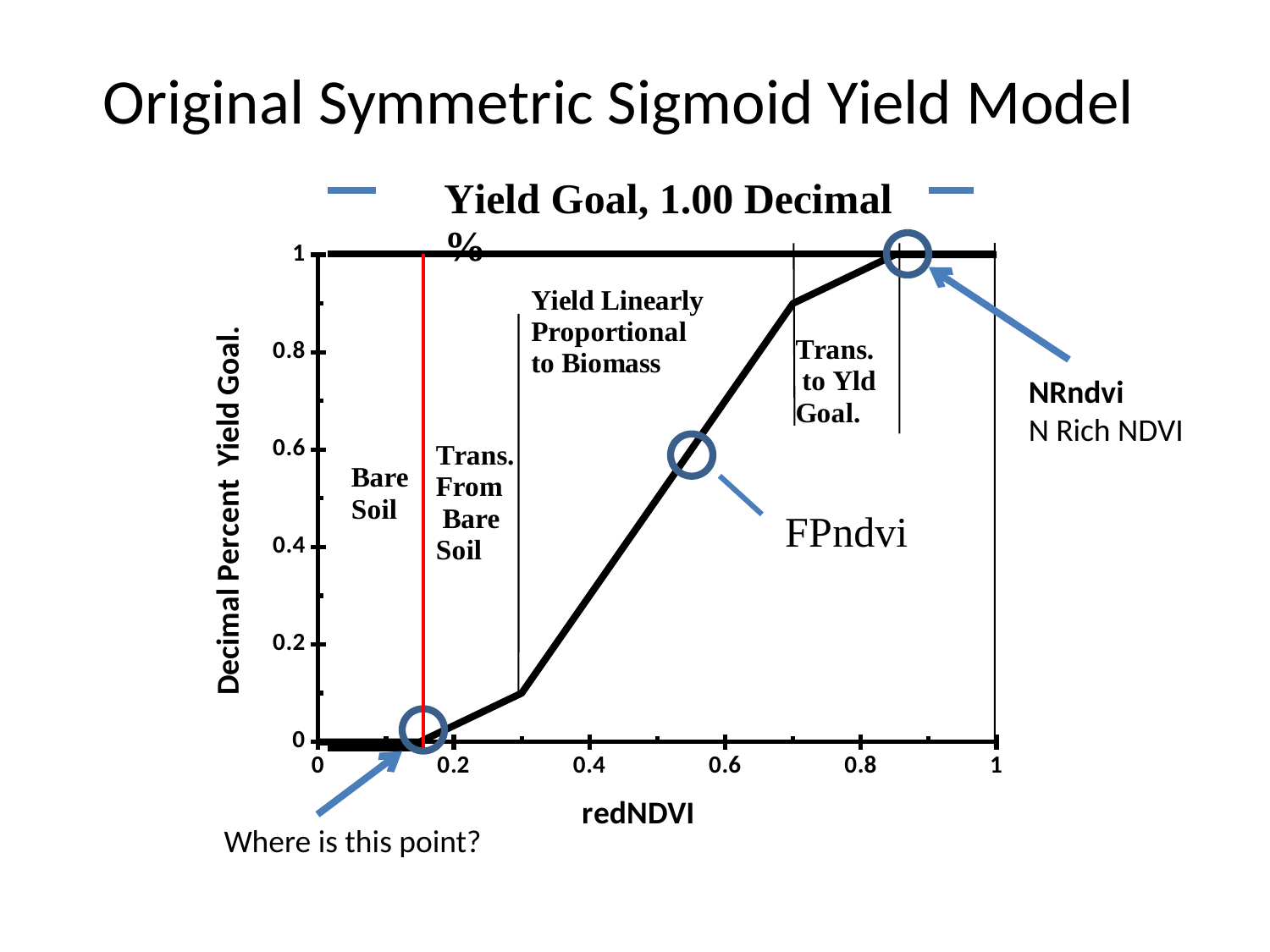
Is the value of the sigmoid curve at redNDVI 0.2 greater or less than 0.2? less Do the values of the sigmoid curve rise or fall as redNDVI increases? rise What is the value of the sigmoid curve at redNDVI 1? 1 What is the value of the sigmoid curve at redNDVI 0? 0 Which has the larger value on the sigmoid curve, redNDVI 0.4 or redNDVI 0.6? redNDVI 0.6 Is the value of the sigmoid curve at redNDVI 0.4 greater or less than 0.6? less What kind of chart is shown on the slide? line chart Is the value of the sigmoid curve at redNDVI 0.6 greater or less than 0.4? greater What is the title of the x axis? redNDVI What is the title of the y axis? Decimal Percent Yield Goal. Which has the larger value on the sigmoid curve, redNDVI 0.2 or redNDVI 0.8? redNDVI 0.8